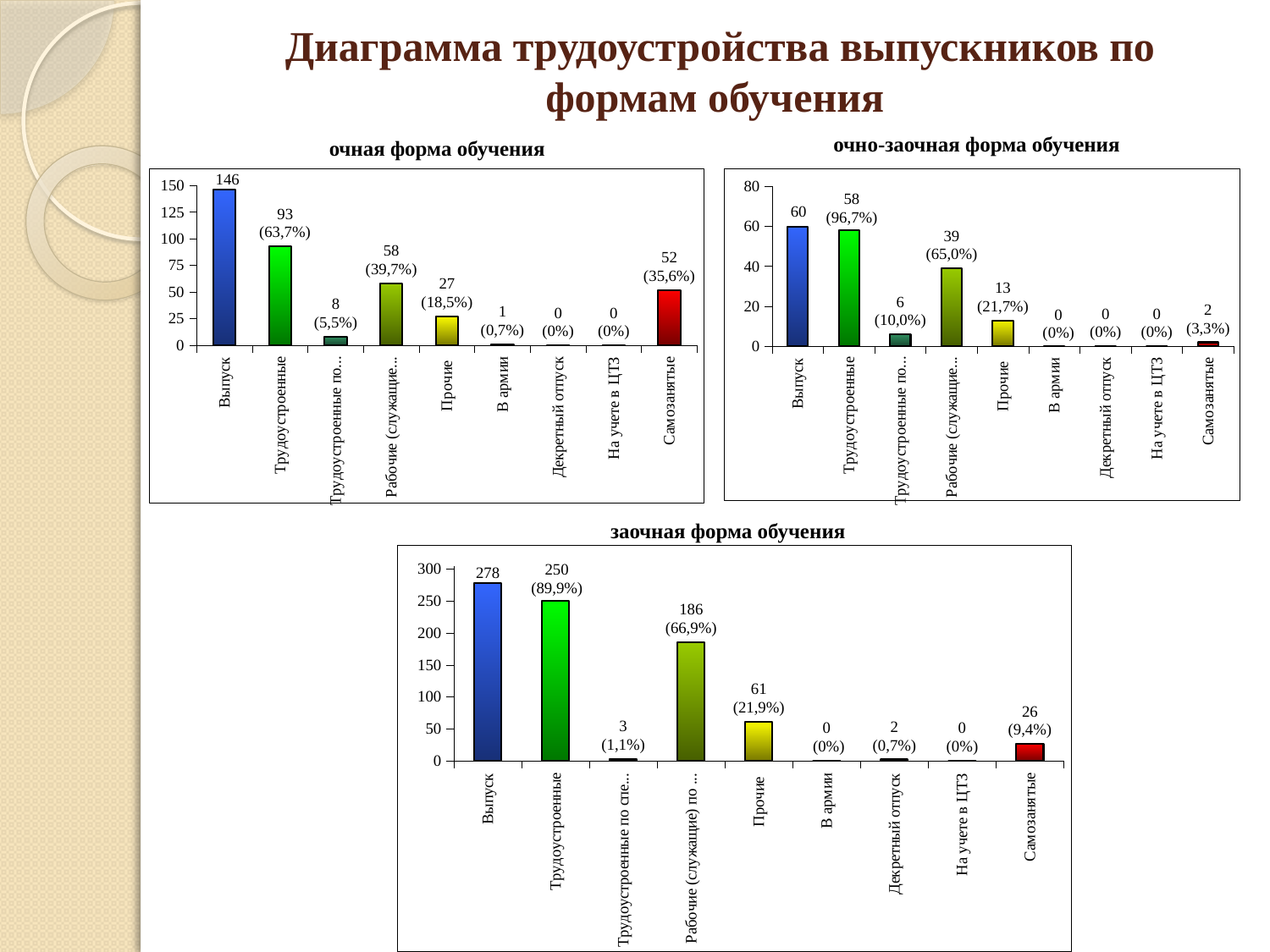
In the chart titled "очно-заочная форма обучения", what is the difference between the values for Выпуск and Трудоустроенные? 2 In the chart titled "очная форма обучения", what is the value for Самозанятые? 52 How many charts are shown on the slide? 3 In the chart titled "очная форма обучения", what is the value for Выпуск? 146 In the chart titled "заочная форма обучения", which category has the highest value? Выпуск In the chart titled "очная форма обучения", is the value for Трудоустроенные greater or less than 75? greater In the chart titled "заочная форма обучения", what is the difference between the values for Трудоустроенные and Рабочие (служащие) по ...? 64 How many categories are shown on the x axis of the chart titled "заочная форма обучения"? 9 What kind of chart is the chart titled "очно-заочная форма обучения"? bar chart In the chart titled "заочная форма обучения", what is the value for Прочие? 61 In the chart titled "очная форма обучения", which is larger: the value for Прочие or the value for Самозанятые? Самозанятые In the chart titled "очно-заочная форма обучения", what is the value for Трудоустроенные? 58